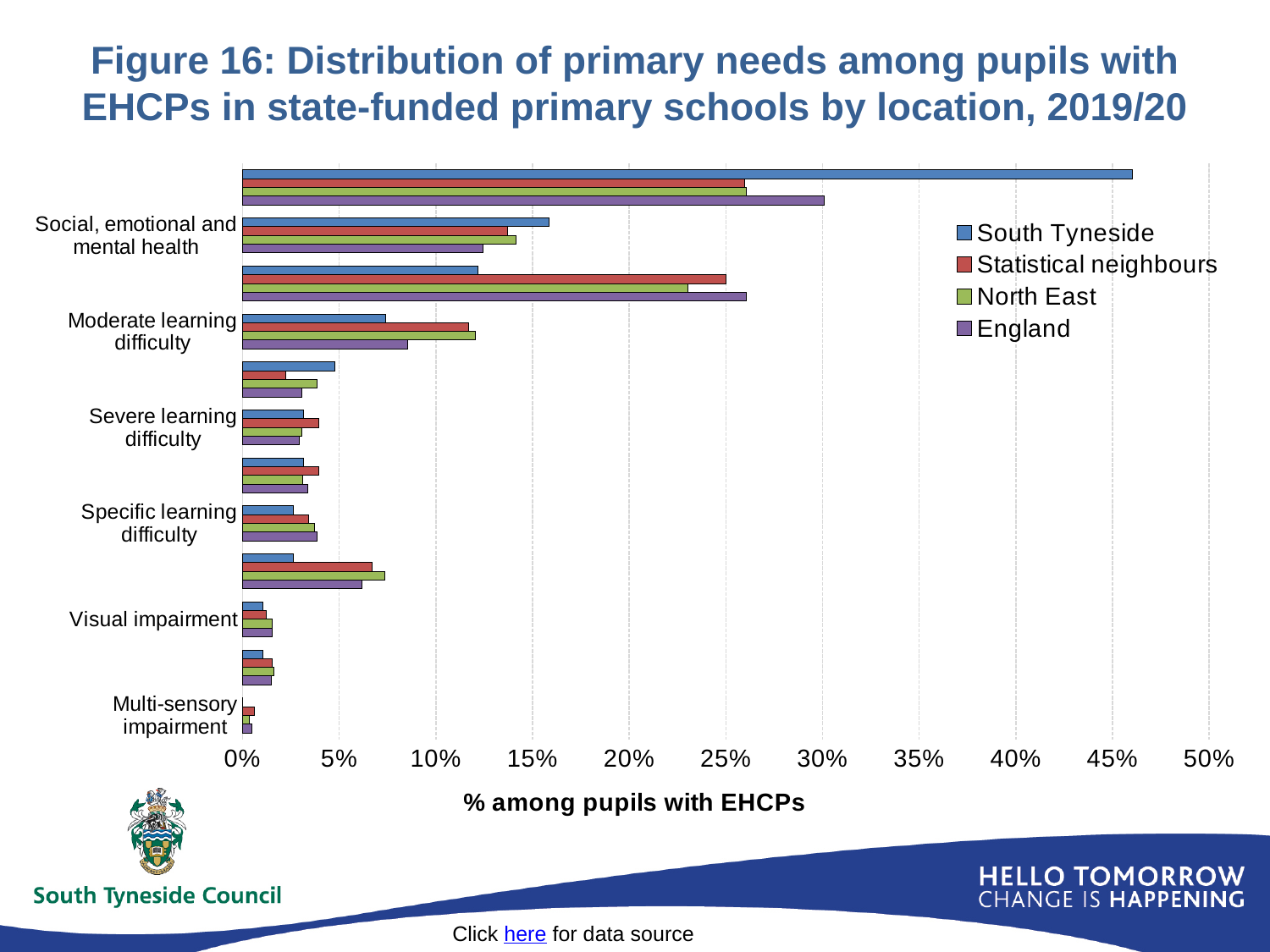
What is the title of the horizontal axis? % among pupils with EHCPs Is the England value for Moderate learning difficulty greater or less than 10%? less For Visual impairment, which is larger: the South Tyneside value or the England value? England For Moderate learning difficulty, which is larger: the South Tyneside value or the Statistical neighbours value? Statistical neighbours Is the England value for Multi-sensory impairment greater or less than 5%? less For Social, emotional and mental health, which series has the highest value? South Tyneside Is the Statistical neighbours value for Moderate learning difficulty greater or less than 10%? greater How many series does the legend list? 4 What kind of chart is shown on the slide? bar chart Which series are listed in the legend? South Tyneside, Statistical neighbours, North East, England For Social, emotional and mental health, which series has the lowest value? England